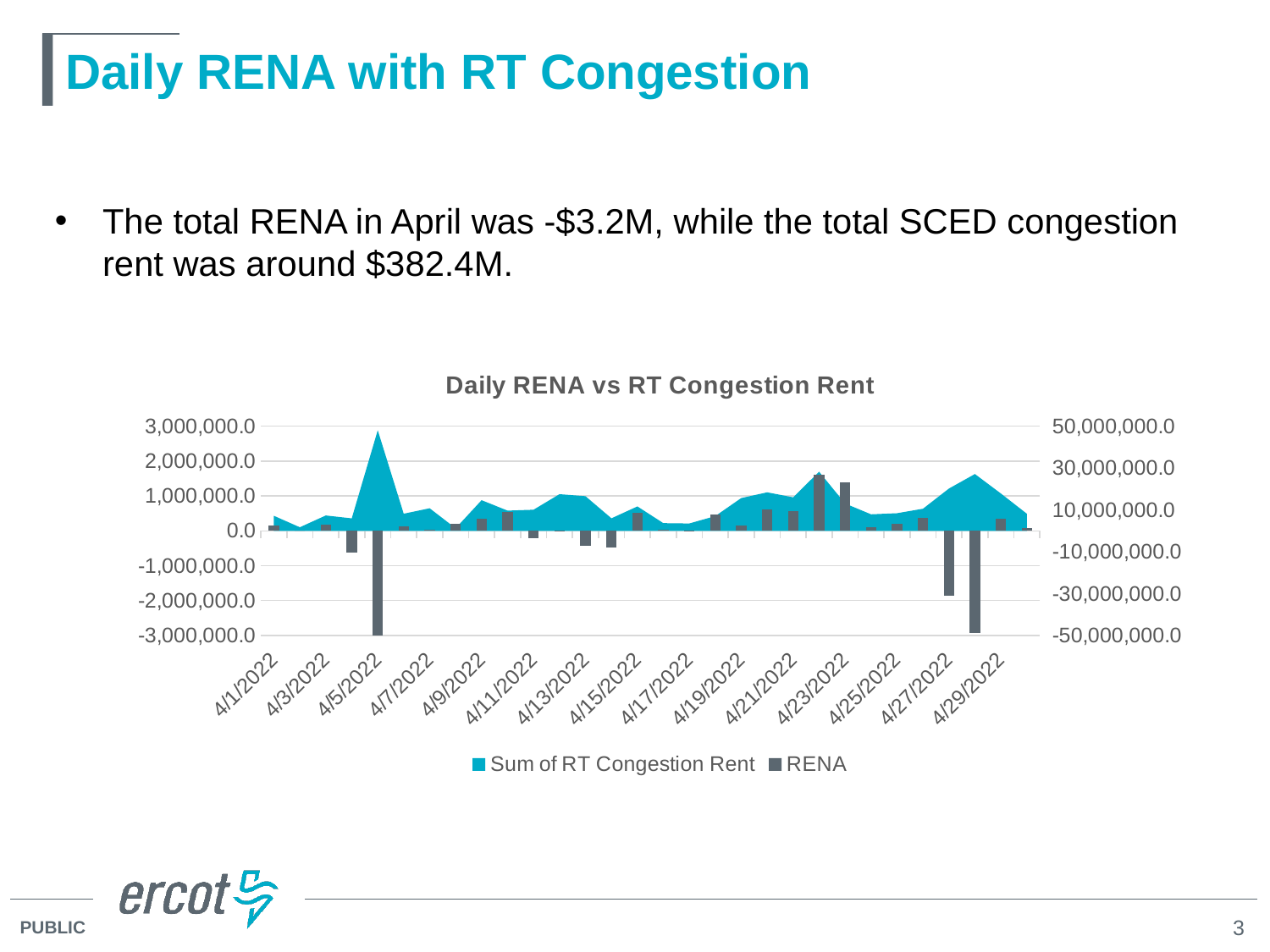
Is the lowest RENA bar on the chart greater or less than -2,000,000.0 on the left axis? less How many date labels are shown along the x axis of the chart? 15 What is the last date label on the chart's x axis? 4/29/2022 What kind of chart is shown on the slide? A combination chart with an area series and a bar series What is the title of the chart on the slide? Daily RENA vs RT Congestion Rent How many series does the chart's legend list? 2 What is the first date label on the chart's x axis? 4/1/2022 What are the two series named in the chart's legend? Sum of RT Congestion Rent and RENA What is the lowest value shown on the chart's right vertical axis? -50,000,000.0 What is the highest value shown on the chart's left vertical axis? 3,000,000.0 Is the peak of the Sum of RT Congestion Rent area greater or less than 30,000,000.0 on the right axis? greater Is the tallest positive RENA bar on the chart greater or less than 1,000,000.0 on the left axis? greater